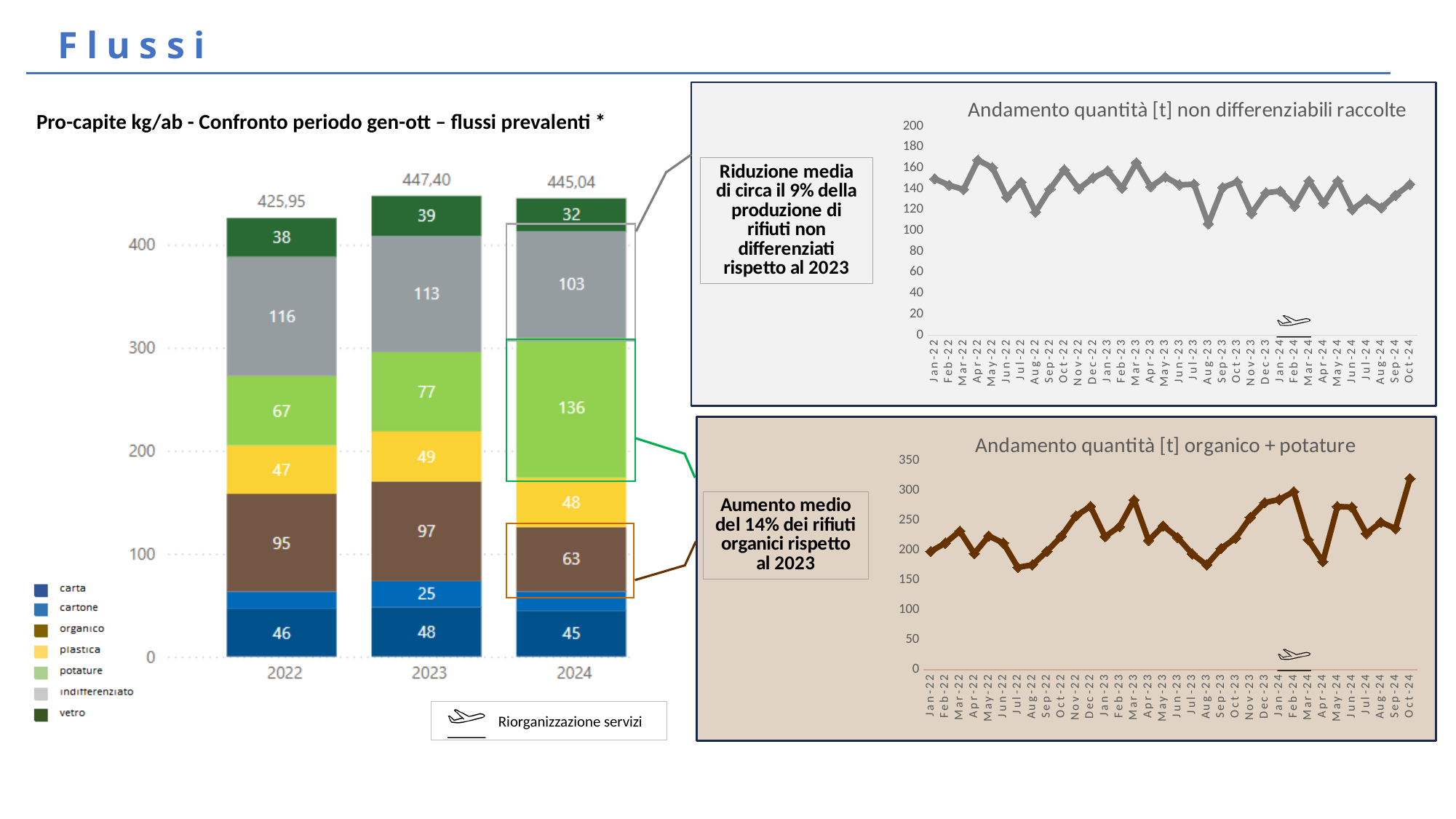
In the stacked bar chart 'Pro-capite kg/ab', what is the difference between the potature value in 2024 and in 2023? 59 How many series does the legend of the stacked bar chart 'Pro-capite kg/ab' list? 7 What kind of chart is the 'Pro-capite kg/ab' chart on the left of the slide? Stacked bar chart In the stacked bar chart 'Pro-capite kg/ab', which year has the highest total? 2023 In the chart 'Andamento quantità [t] organico + potature', is the value for Oct-24 greater or less than 300? greater How many years are shown on the x axis of the stacked bar chart 'Pro-capite kg/ab'? 3 In the chart 'Andamento quantità [t] non differenziabili raccolte', is the value for Aug-23 greater or less than 120? less In the stacked bar chart 'Pro-capite kg/ab', what is the value of the indifferenziato segment for 2024? 103 In the stacked bar chart 'Pro-capite kg/ab', is the organico value larger in 2022 or in 2024? 2022 In the stacked bar chart 'Pro-capite kg/ab', what is the difference between the vetro value in 2022 and in 2024? 6 What kind of chart is 'Andamento quantità [t] organico + potature'? Line chart In the stacked bar chart 'Pro-capite kg/ab', what is the total value shown above the 2023 bar? 447,40